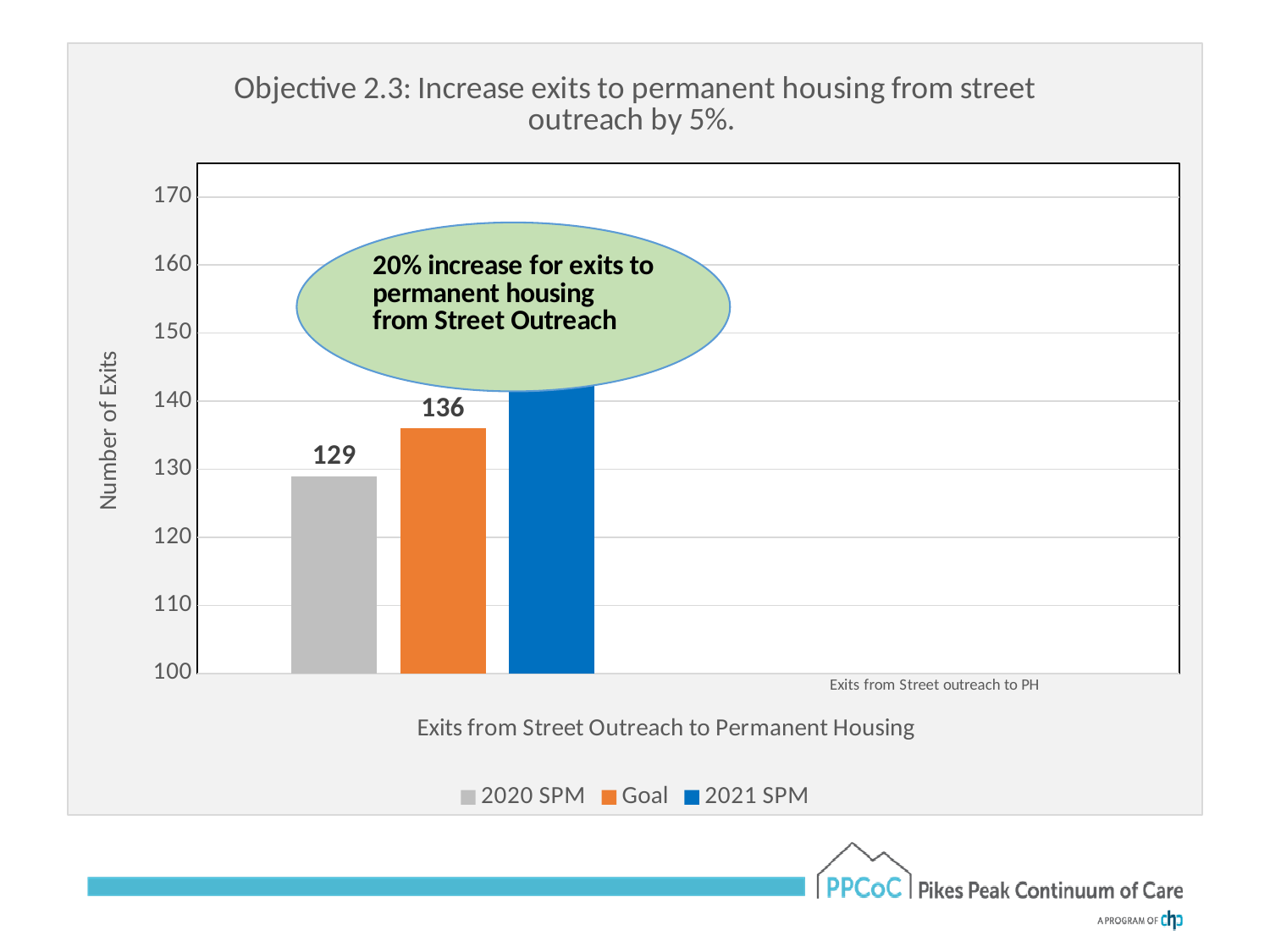
What kind of chart is shown on the slide? bar chart Is the value for 2021 SPM greater or less than 140? greater What is the value of the Goal bar? 136 What is the difference between the Goal value and the 2020 SPM value? 7 What is the value of the 2020 SPM bar? 129 How many series does the legend list? 3 Which is larger, the Goal bar or the 2020 SPM bar? Goal What colour is the Goal bar? orange Which series has the highest bar? 2021 SPM Which series has the lowest bar? 2020 SPM How many categories are shown on the x axis? 1 What is the label of the y axis? Number of Exits